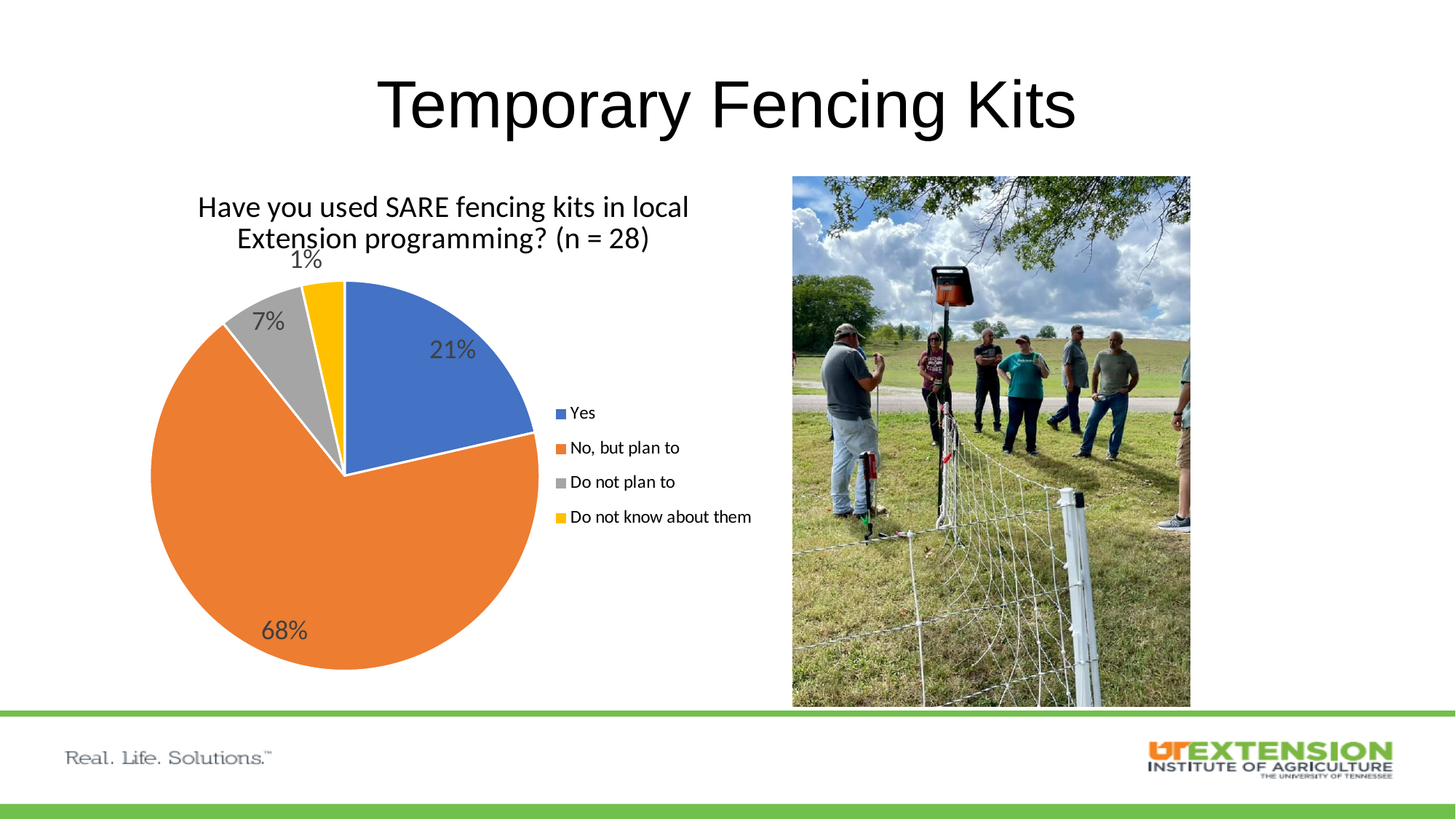
Which response has the smallest share of the pie? Do not know about them What colour represents "No, but plan to" in the pie chart? Orange Which response has the largest share of the pie? No, but plan to What percentage of respondents answered "Do not plan to"? 7% What percentage of respondents answered "No, but plan to"? 68% What is the difference in percentage points between "No, but plan to" and "Yes"? 47 What percentage of respondents answered "Do not know about them"? 1% Which is larger: the share for "Yes" or the share for "Do not plan to"? Yes What type of chart is shown on the slide? Pie chart How many categories does the pie chart show? 4 What is the title of the pie chart? Have you used SARE fencing kits in local Extension programming? (n = 28) What percentage of respondents answered "Yes"? 21%